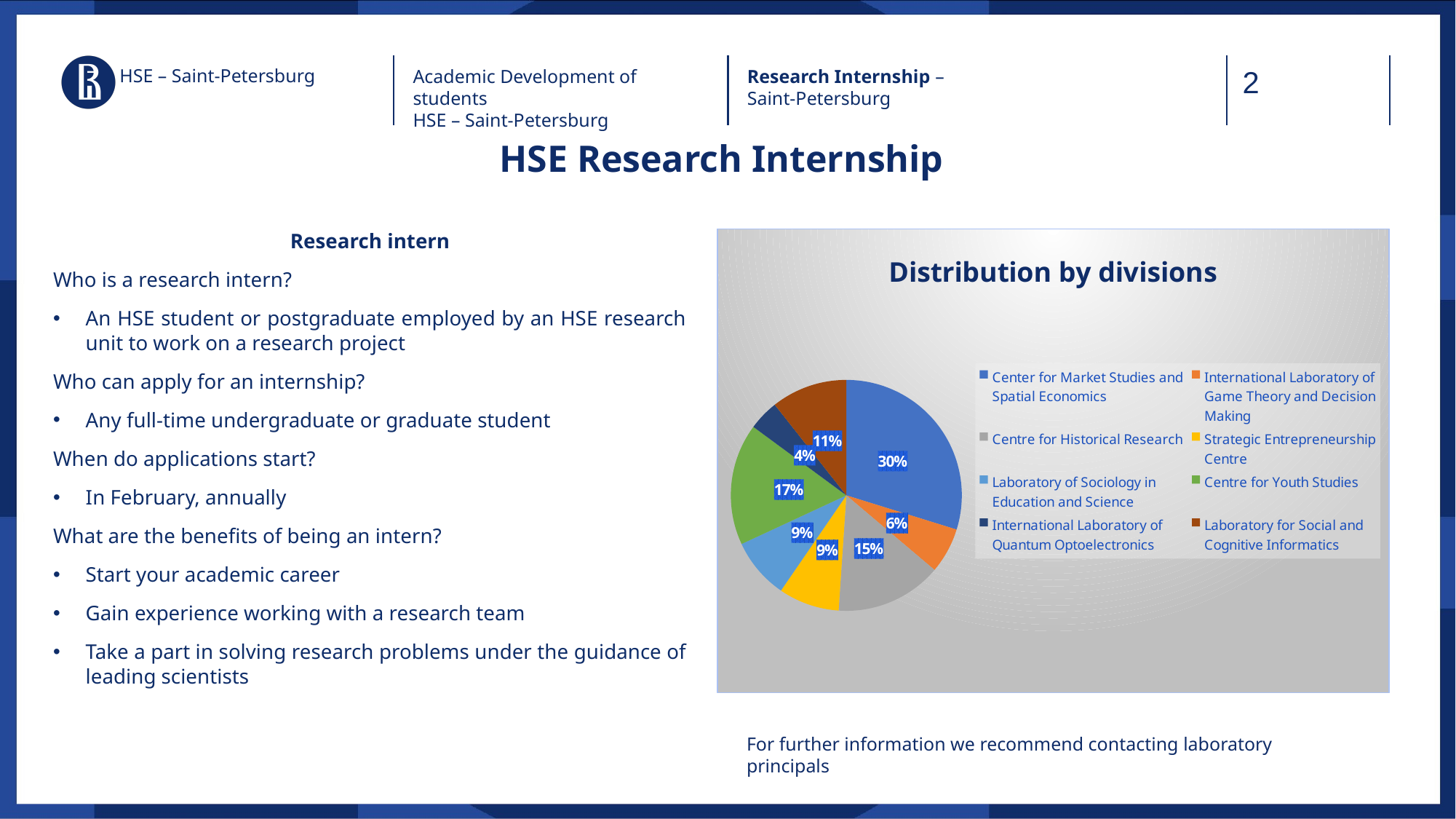
What kind of chart is shown on the slide? pie chart What share of the pie does the International Laboratory of Quantum Optoelectronics have? 4% Which division has the smallest share of the pie? International Laboratory of Quantum Optoelectronics What share of the pie does the Centre for Youth Studies have? 17% What is the difference in percentage points between the Centre for Youth Studies and the International Laboratory of Game Theory and Decision Making? 11 Which division has the largest share of the pie? Center for Market Studies and Spatial Economics What share of the pie does the Laboratory for Social and Cognitive Informatics have? 11% How many divisions are shown in the pie chart? 8 What is the title of the chart? Distribution by divisions Which has a larger share: the Centre for Historical Research or the Laboratory for Social and Cognitive Informatics? Centre for Historical Research